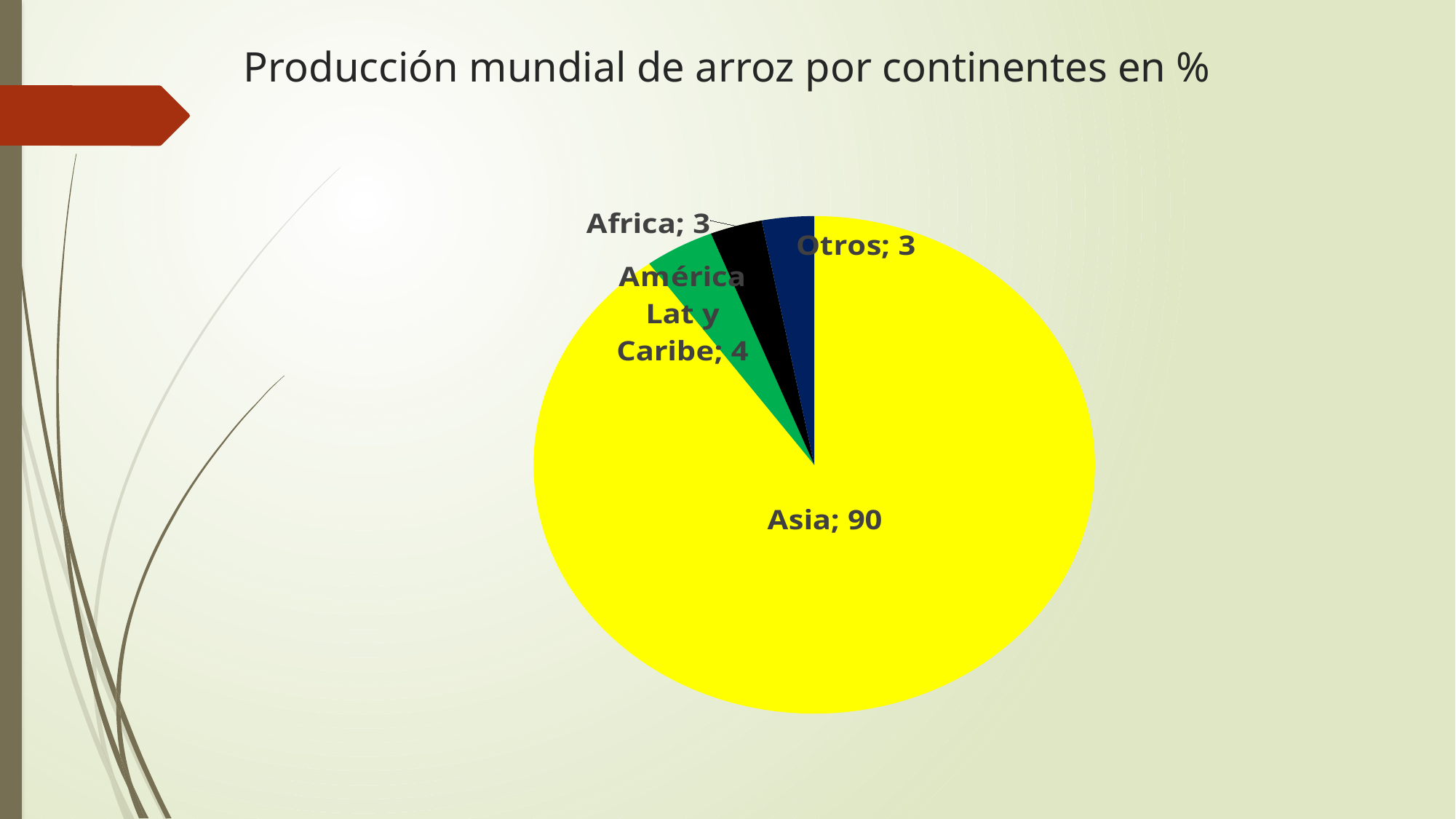
Which category has the largest slice of the pie chart? Asia What type of chart is shown on the slide? pie chart What is the value for Otros in the pie chart? 3 What colour is the slice for Asia in the pie chart? yellow What is the title of the chart on the slide? Producción mundial de arroz por continentes en % Which is larger, the value for América Lat y Caribe or the value for Africa? América Lat y Caribe What is the value for América Lat y Caribe in the pie chart? 4 What is the total of all the values shown in the pie chart? 100 What is the value for Asia in the pie chart? 90 What is the value for Africa in the pie chart? 3 How many slices does the pie chart have? 4 What is the difference between the values for Asia and América Lat y Caribe? 86